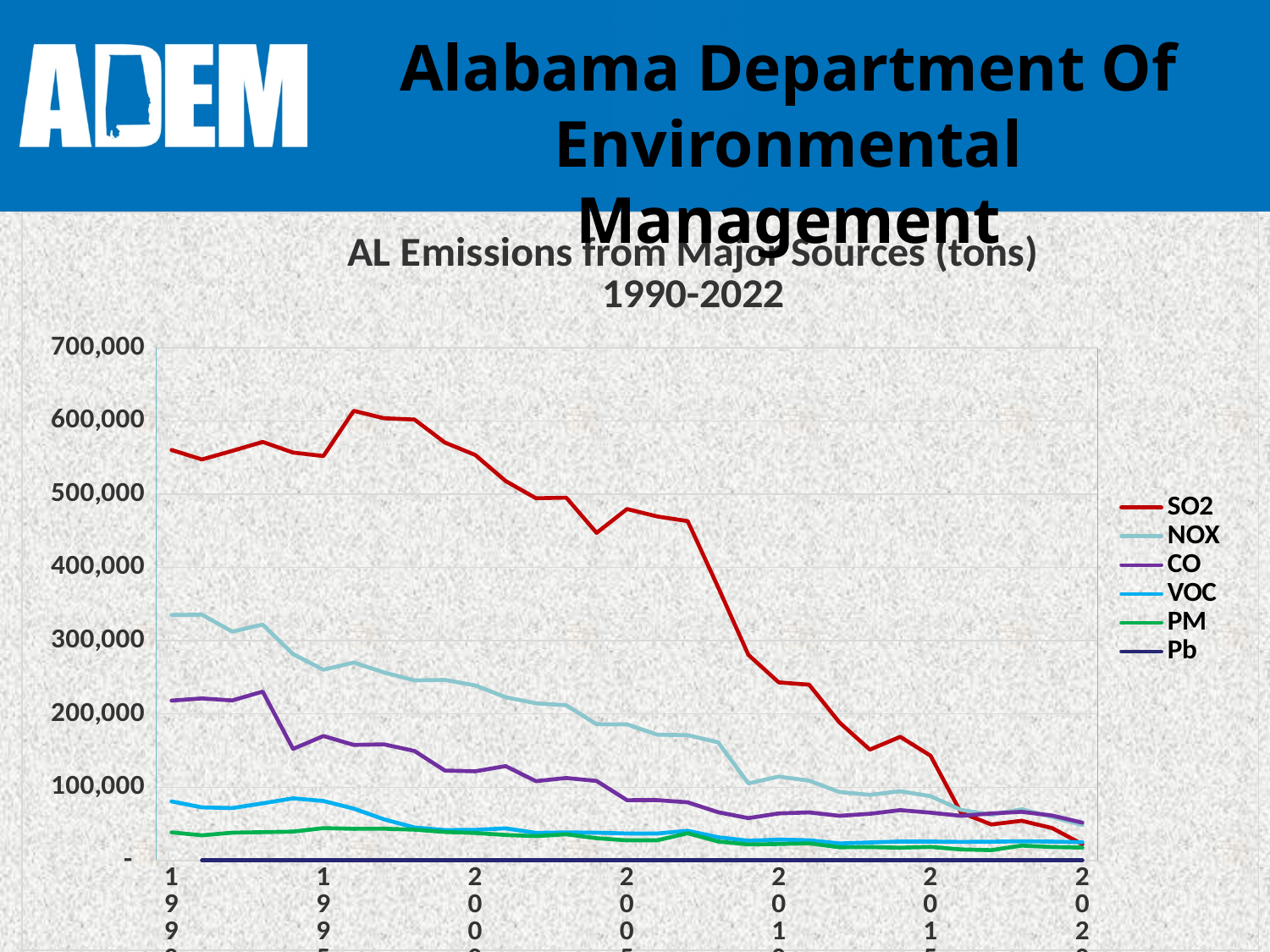
Which series is drawn in red? SO2 Do NOX emissions rise or fall over the period shown? fall At the start of the period, which is larger, SO2 or NOX? SO2 What type of chart is shown on the slide? line chart What is the title of the chart? AL Emissions from Major Sources (tons) 1990-2022 Is the SO2 value at the start of the period greater or less than 500,000? greater Which series has the highest emissions at the start of the period? SO2 Is the NOX value at the start of the period greater or less than 300,000? greater Is the CO value at the start of the period greater or less than 200,000? greater How many series does the legend list? 6 Which series has the lowest emissions throughout the period? Pb Do SO2 emissions rise or fall over the period shown? fall